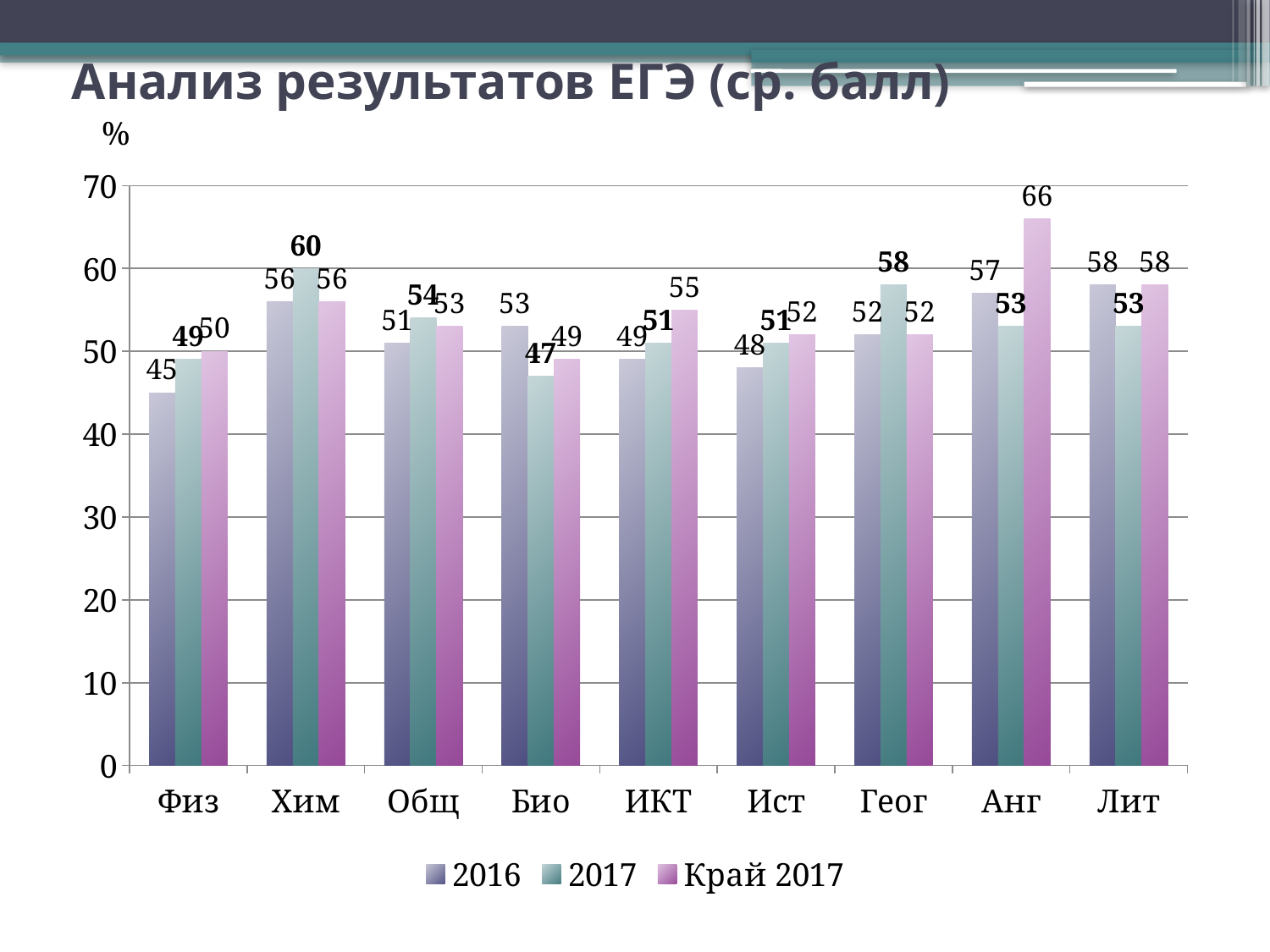
What is the value for 2017 in the Хим category? 60 How many categories are shown on the x axis? 9 What is the value for Край 2017 in the Анг category? 66 How many series does the legend list? 3 What is the difference between the 2017 value and the 2016 value in the Физ category? 4 What is the difference between the Край 2017 value and the 2017 value in the Анг category? 13 In the Био category, which series has the larger value, 2016 or 2017? 2016 What kind of chart is shown on the slide? Bar chart Which category has the highest value for the Край 2017 series? Анг Which category has the lowest value for the 2016 series? Физ Which category has the highest value for the 2017 series? Хим What is the value for 2016 in the Лит category? 58